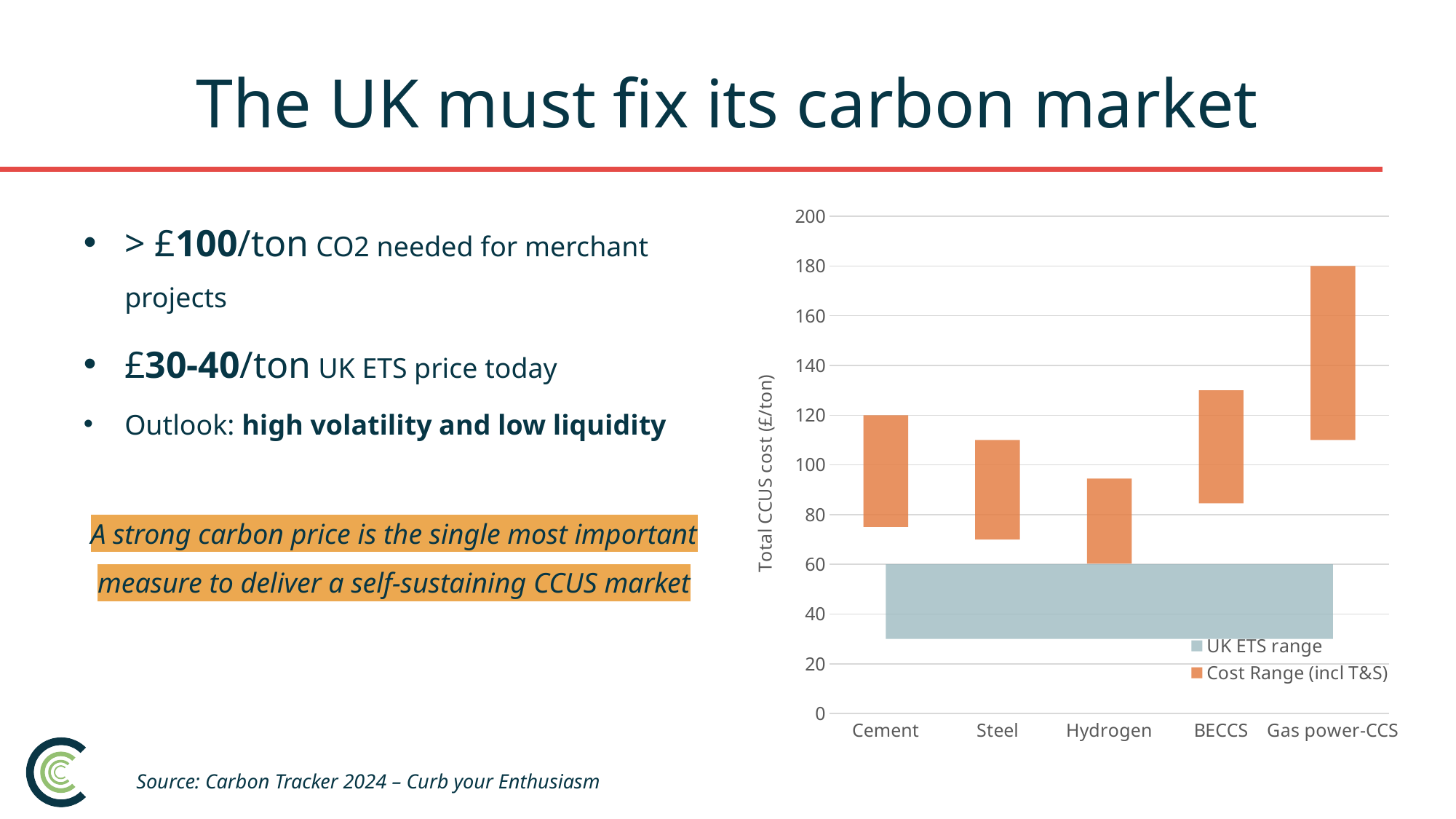
Which category has the highest upper end of its cost range? Gas power-CCS What is the upper end of the cost range for Gas power-CCS, in £/ton? 180 What is the upper end of the cost range for Cement, in £/ton? 120 What kind of chart is shown on the slide? bar chart Is the upper end of the cost range for BECCS greater or less than 120? greater Which category has the lowest lower end of its cost range? Hydrogen How many categories are shown on the x axis of the chart? 5 Which has the higher upper end of its cost range, Cement or Steel? Cement What is the title of the chart's vertical axis? Total CCUS cost (£/ton) How many series does the chart legend list? 2 Is the lower end of the cost range for Steel greater or less than 80? less